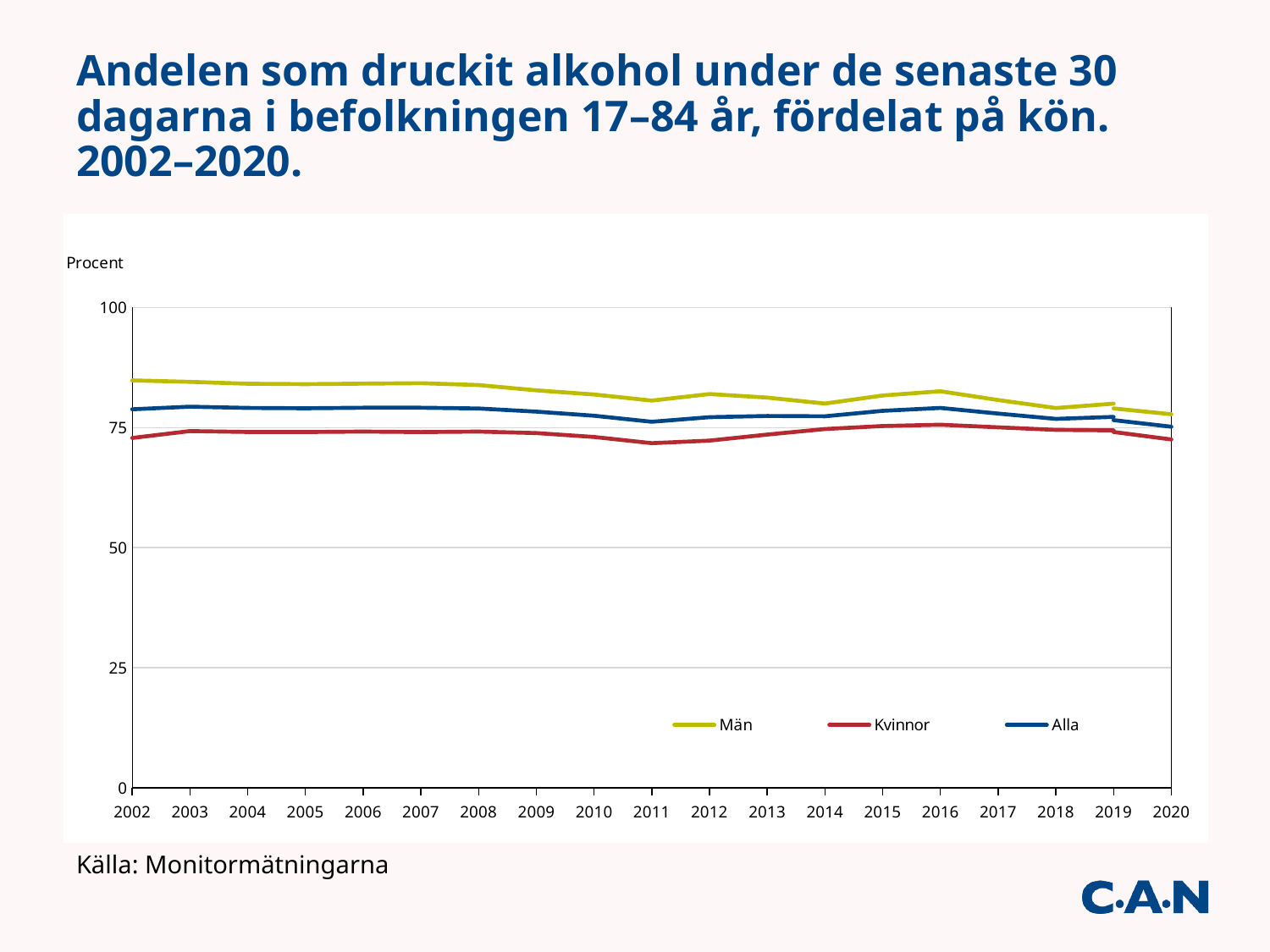
How many years are plotted along the x axis? 19 Which is larger in 2016, the value for Män or the value for Kvinnor? Män What label is shown on the y axis of the chart? Procent Is the value for Män in 2002 greater or less than 75? greater Does the Män line rise or fall overall from 2002 to 2020? fall How many series does the legend list? 3 Is the value for Alla in 2002 greater or less than 75? greater What kind of chart is shown on the slide? line chart Is the value for Kvinnor in 2011 greater or less than 75? less Which series has the highest values across the chart? Män Which series has the lowest values across the chart? Kvinnor